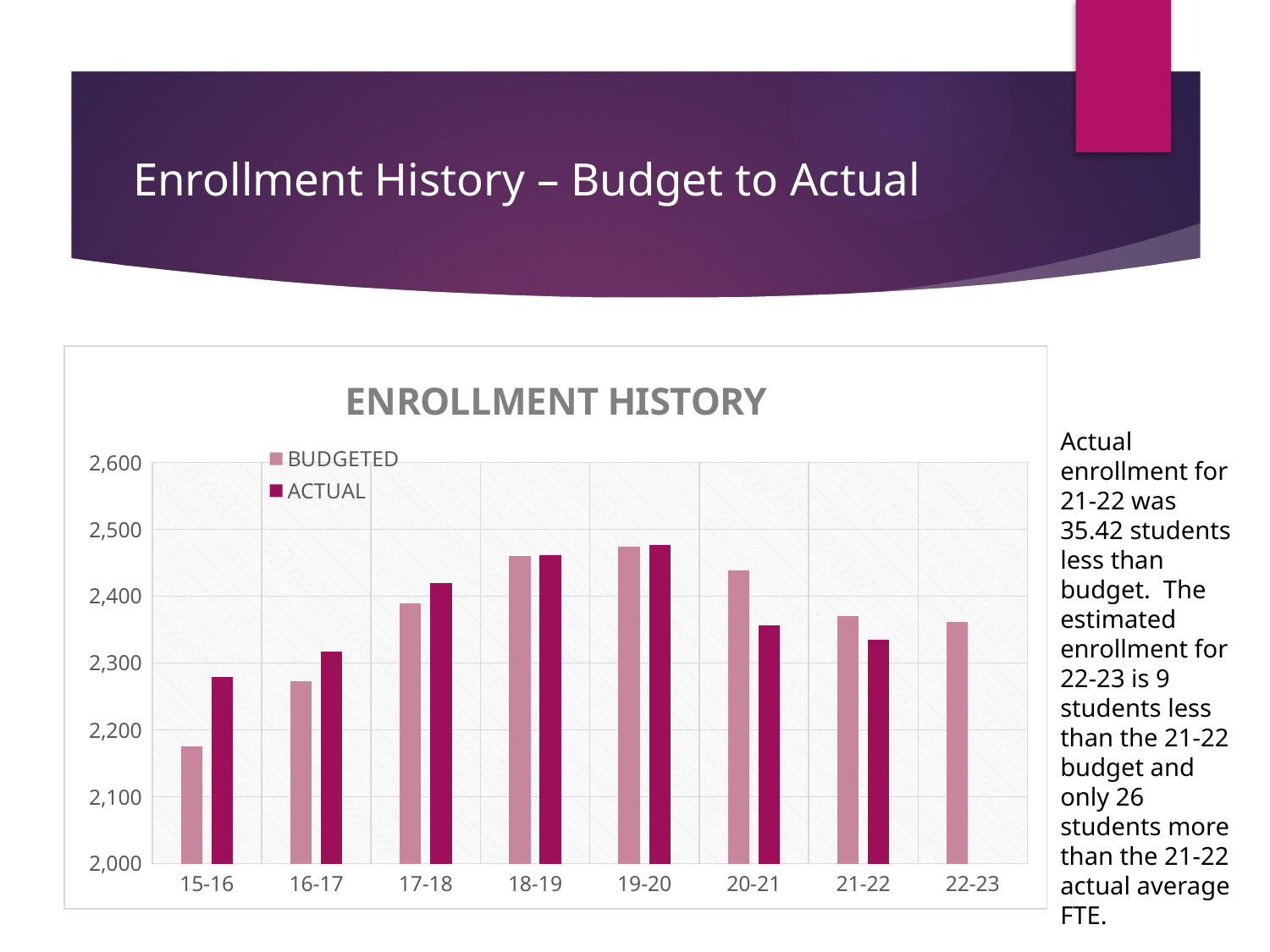
Is the ACTUAL value for 20-21 greater or less than 2,400? less Is the BUDGETED value for 15-16 greater or less than 2,200? less What are the two series named in the legend of the Enrollment History chart? BUDGETED and ACTUAL Which school year in the Enrollment History chart has only a BUDGETED bar and no ACTUAL bar? 22-23 How many series does the legend of the Enrollment History chart list? 2 Is the ACTUAL value for 17-18 greater or less than 2,400? greater For 15-16, which is larger: the BUDGETED or the ACTUAL enrollment? ACTUAL For 20-21, which is larger: the BUDGETED or the ACTUAL enrollment? BUDGETED How many school years are shown along the x axis of the Enrollment History chart? 8 Which school year has the lowest ACTUAL enrollment in the Enrollment History chart? 15-16 What kind of chart is shown on the slide? Bar chart Which school year has the lowest BUDGETED enrollment in the Enrollment History chart? 15-16